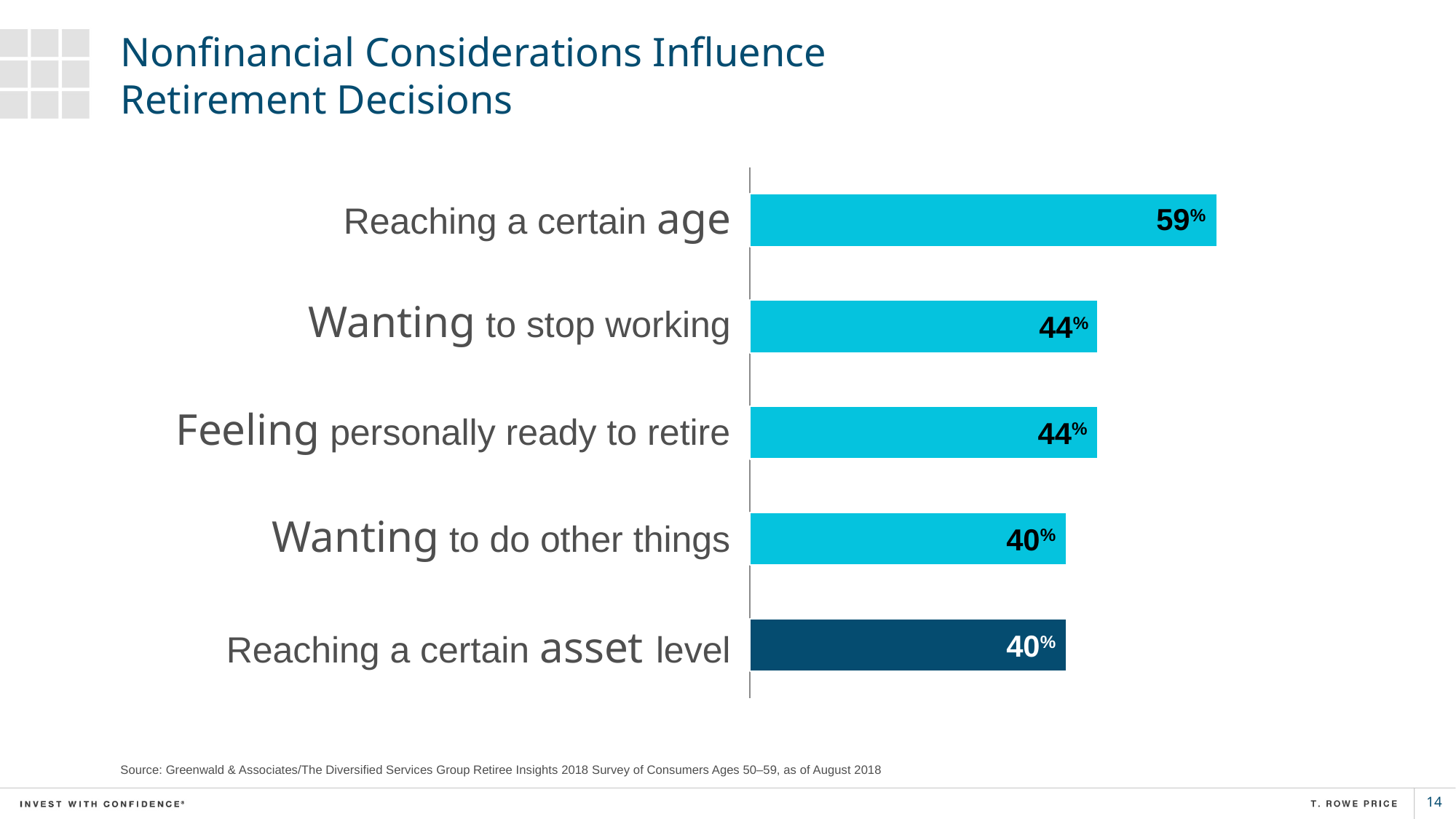
What kind of chart is shown on the slide? Bar chart What is the difference between the values for "Wanting to stop working" and "Wanting to do other things"? 4% Which is larger, the value for "Reaching a certain age" or the value for "Reaching a certain asset level"? Reaching a certain age What percentage is shown for "Reaching a certain age"? 59% How many categories are shown in the chart? 5 What percentage is shown for "Wanting to stop working"? 44% What percentage is shown for "Reaching a certain asset level"? 40% Which bar is shown in a different, darker colour from the others? Reaching a certain asset level Which category has the highest value? Reaching a certain age What percentage is shown for "Feeling personally ready to retire"? 44% What is the difference between the values for "Reaching a certain age" and "Wanting to stop working"? 15% What percentage is shown for "Wanting to do other things"? 40%